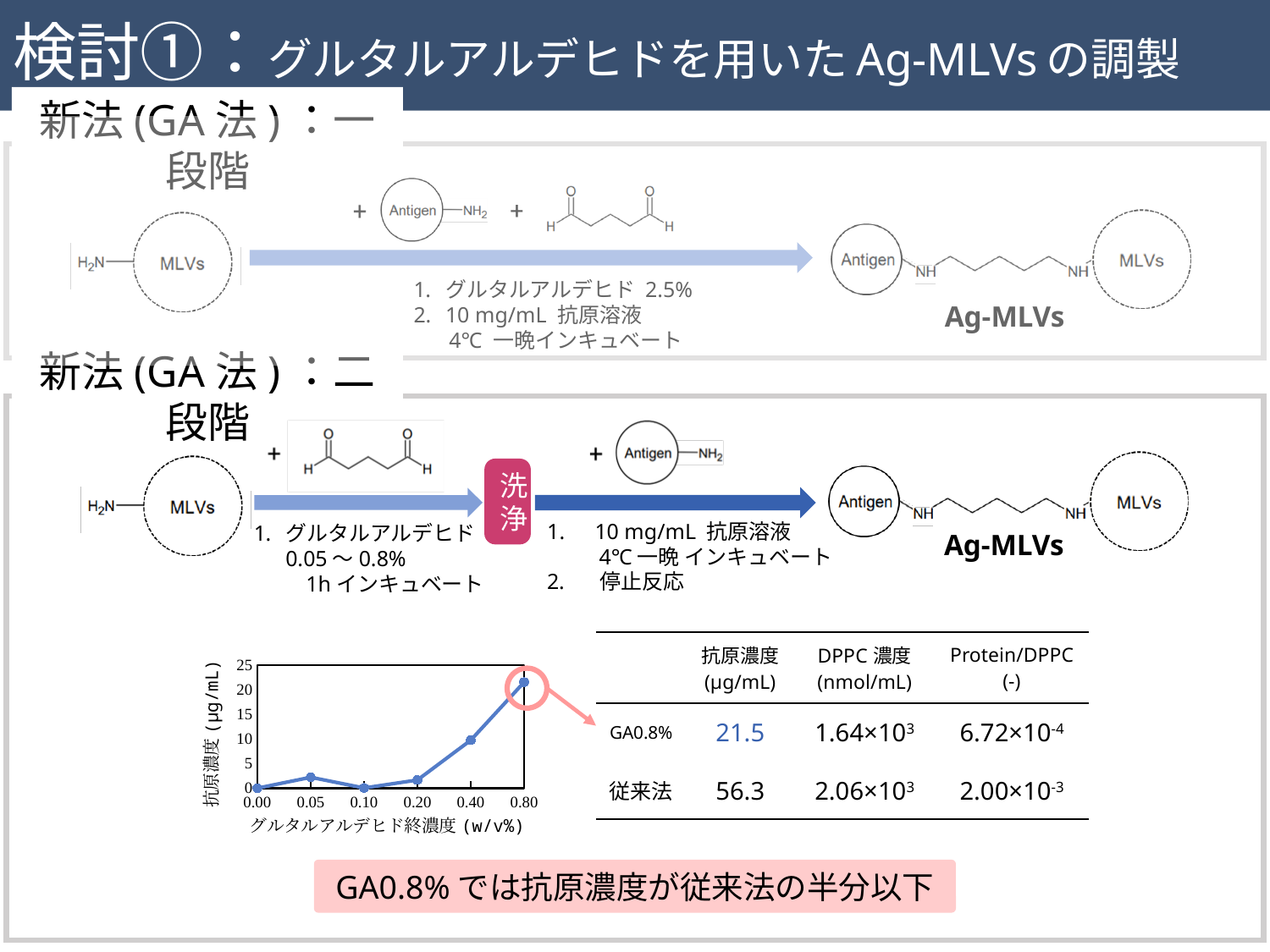
What kind of chart is shown at the bottom left of the slide? line chart What is the antigen concentration (μg/mL) at a glutaraldehyde final concentration of 0.80 w/v%, as indicated by the circled point and the linked table? 21.5 Is the antigen concentration at 0.20 w/v% glutaraldehyde greater or less than 5 μg/mL? less What is the label of the x axis of the line chart? グルタルアルデヒド終濃度 (w/v%) How many data points are plotted on the line chart? 6 Which has the higher antigen concentration on the line chart: 0.40 w/v% or 0.80 w/v% glutaraldehyde? 0.80 At which glutaraldehyde final concentration (w/v%) is the antigen concentration highest on the line chart? 0.80 Is the antigen concentration at 0.80 w/v% glutaraldehyde greater or less than 20 μg/mL? greater Which has the higher antigen concentration on the line chart: 0.05 w/v% or 0.40 w/v% glutaraldehyde? 0.40 What is the highest tick value shown on the y axis of the line chart? 25 Is the antigen concentration at 0.40 w/v% glutaraldehyde greater or less than 5 μg/mL? greater Overall, does the antigen concentration rise or fall as the glutaraldehyde final concentration increases along the x axis? rise